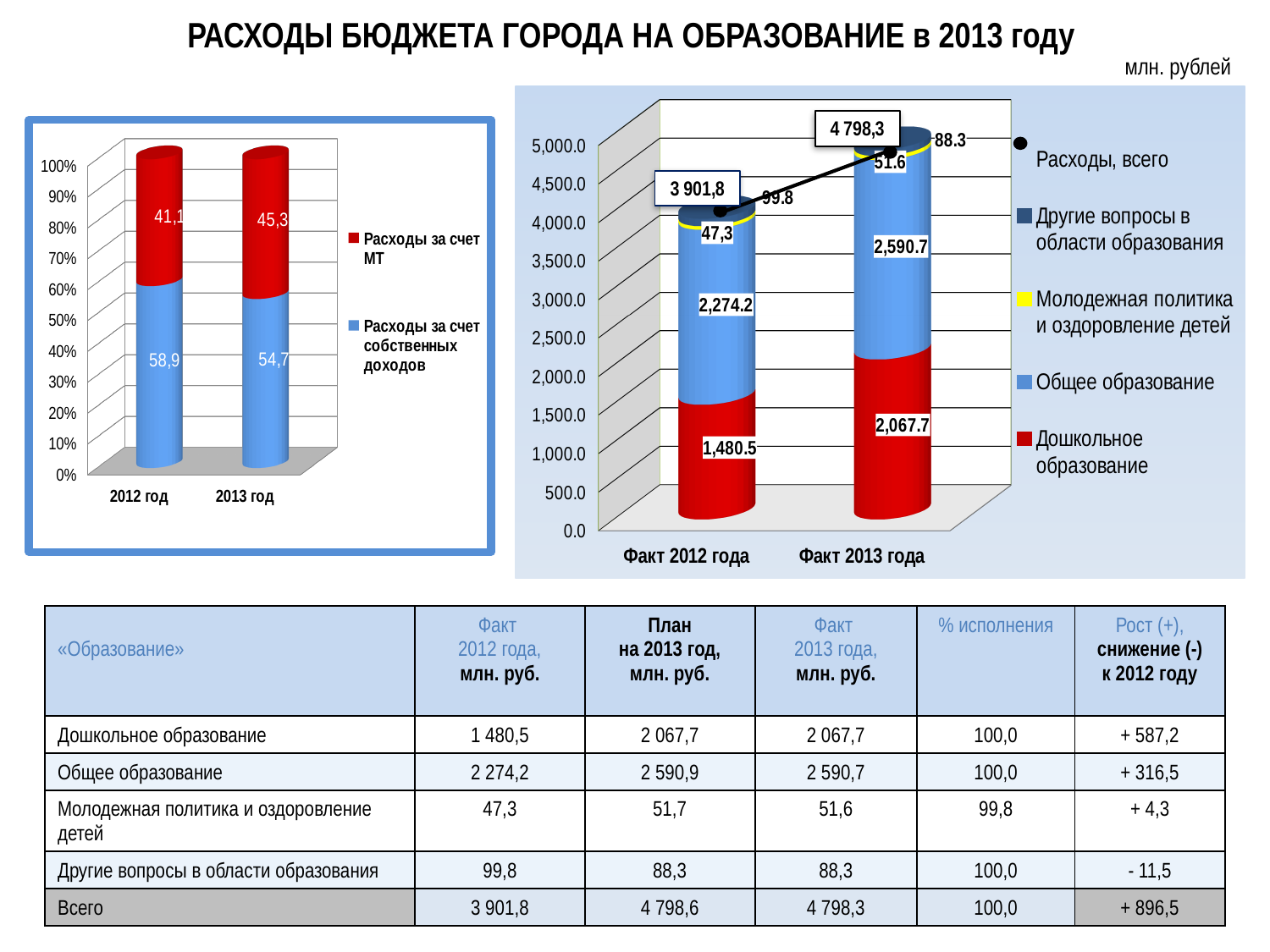
In the right chart, what is the difference in 'Дошкольное образование' between Факт 2013 года and Факт 2012 года? 587.2 In the left chart, which year has the larger share of 'Расходы за счет МТ', 2012 год or 2013 год? 2013 год What type of chart is the right chart? stacked bar chart In the right chart, what is the value of 'Молодежная политика и оздоровление детей' for Факт 2012 года? 47.3 In the right chart, what is the total 'Расходы, всего' for Факт 2013 года? 4 798,3 In the left chart, what is the value of 'Расходы за счет собственных доходов' for 2012 год? 58,9 In the right chart, does 'Расходы, всего' rise or fall from Факт 2012 года to Факт 2013 года? rise In the left chart, what is the value of 'Расходы за счет МТ' for 2013 год? 45,3 In the right chart, how many categories are shown on the x axis? 2 In the right chart, what is the value of 'Общее образование' for Факт 2012 года? 2,274.2 In the right chart, what is the value of 'Дошкольное образование' for Факт 2013 года? 2,067.7 In the left chart, how many series does the legend list? 2